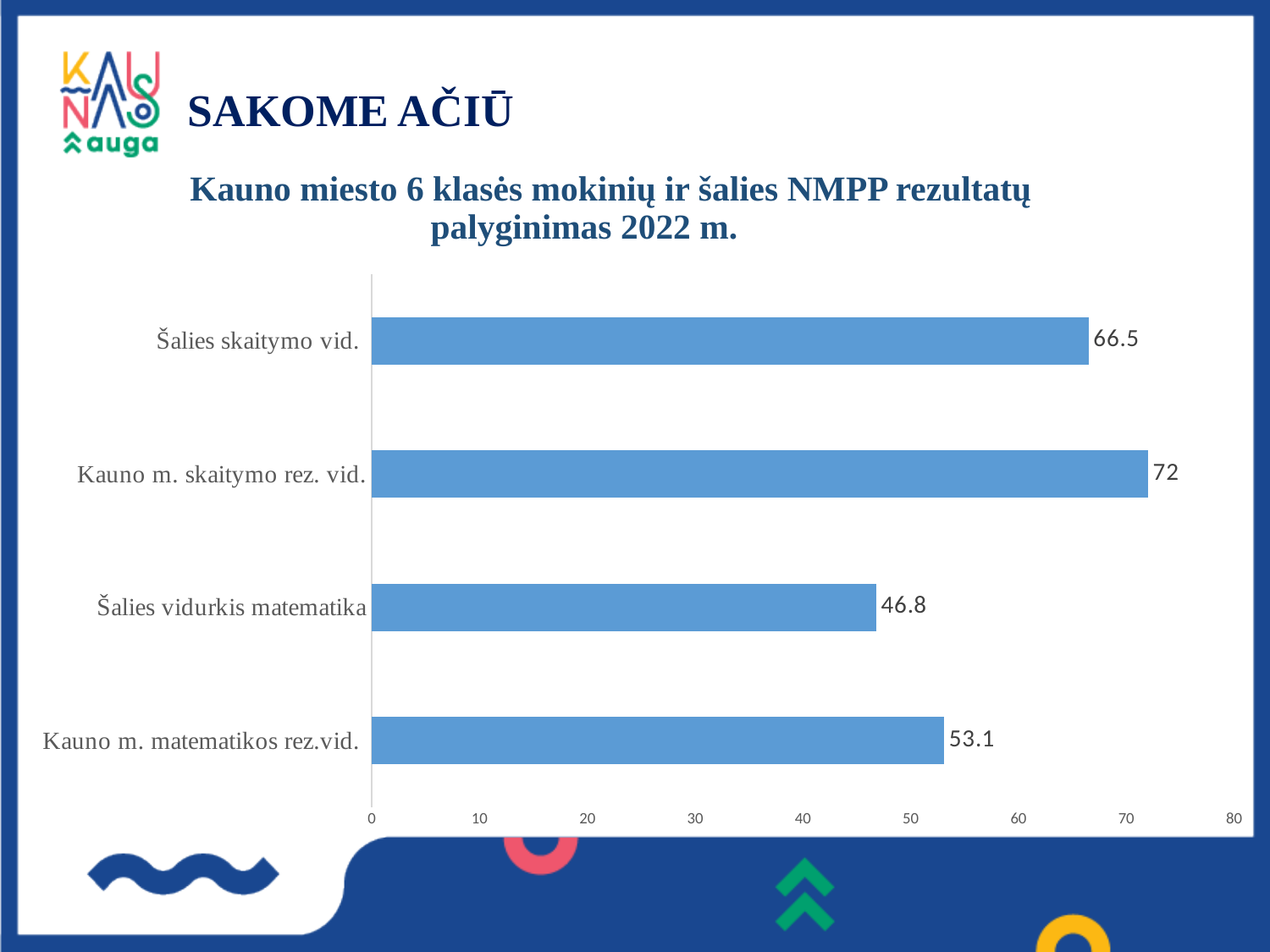
What is the value for Kauno m. skaitymo rez. vid.? 72 What is the value for Šalies vidurkis matematika? 46.8 Which category has the highest value? Kauno m. skaitymo rez. vid. What kind of chart is shown on the slide? Bar chart Which is larger, Šalies skaitymo vid. or Kauno m. matematikos rez.vid.? Šalies skaitymo vid. What is the title of the chart? Kauno miesto 6 klasės mokinių ir šalies NMPP rezultatų palyginimas 2022 m. What is the difference between Kauno m. matematikos rez.vid. and Šalies vidurkis matematika? 6.3 How many categories are shown in the chart? 4 What is the value for Kauno m. matematikos rez.vid.? 53.1 What is the difference between Kauno m. skaitymo rez. vid. and Šalies skaitymo vid.? 5.5 Which category has the lowest value? Šalies vidurkis matematika What is the value for Šalies skaitymo vid.? 66.5